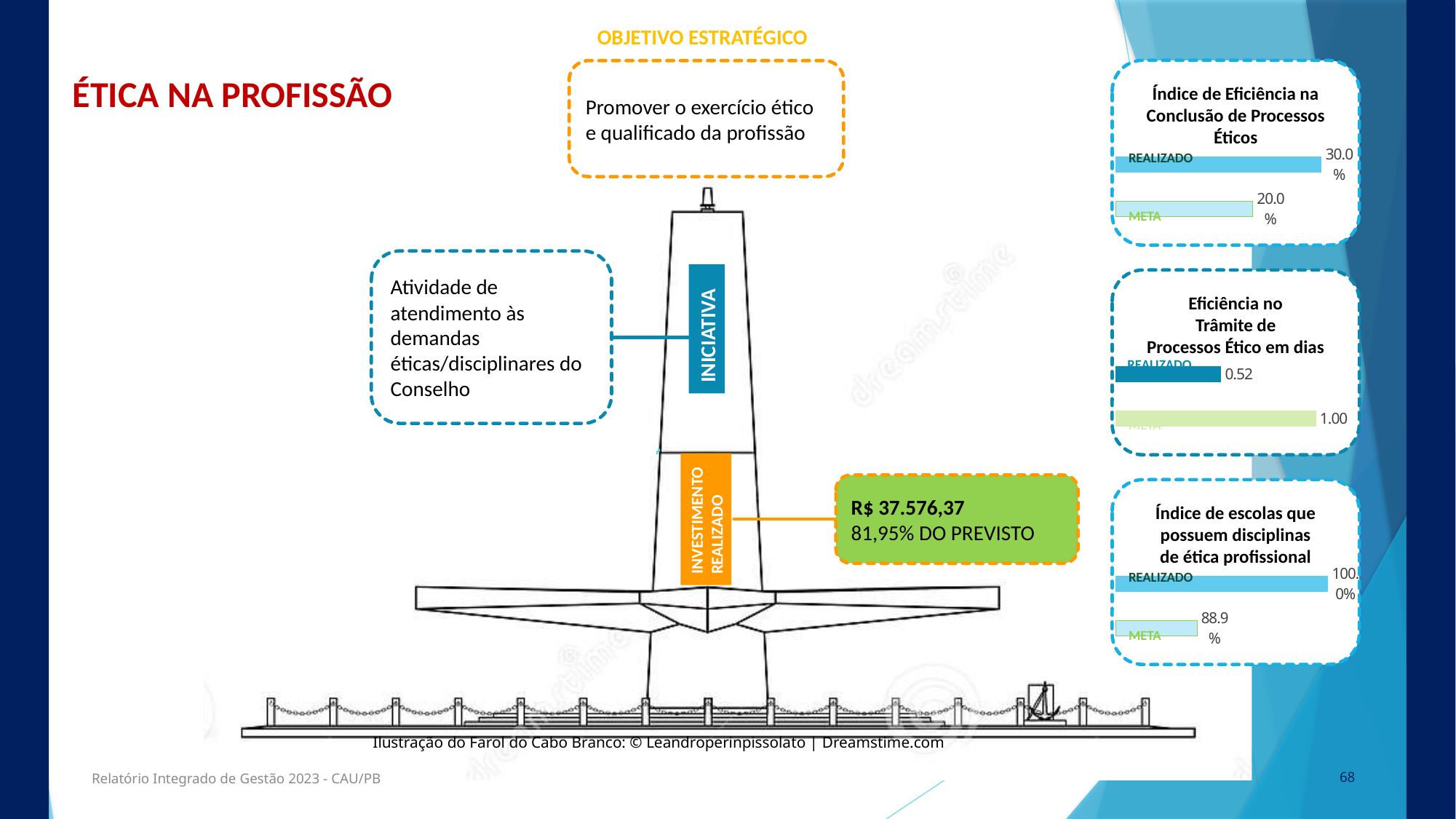
In the chart 'Índice de escolas que possuem disciplinas de ética profissional', which bar is the lowest? META In the chart 'Índice de escolas que possuem disciplinas de ética profissional', what is the value for META? 88.9% In the chart 'Índice de Eficiência na Conclusão de Processos Éticos', what is the value for REALIZADO? 30.0% In the chart 'Índice de Eficiência na Conclusão de Processos Éticos', what is the value for META? 20.0% In the chart 'Eficiência no Trâmite de Processos Ético em dias', what is the value for META? 1.00 What type of chart is 'Eficiência no Trâmite de Processos Ético em dias'? Bar chart In the chart 'Eficiência no Trâmite de Processos Ético em dias', which bar is larger, REALIZADO or META? META In the chart 'Índice de escolas que possuem disciplinas de ética profissional', what is the value for REALIZADO? 100.0% In the chart 'Índice de Eficiência na Conclusão de Processos Éticos', which bar is larger, REALIZADO or META? REALIZADO How many bars does the chart 'Índice de escolas que possuem disciplinas de ética profissional' show? 2 In the chart 'Índice de Eficiência na Conclusão de Processos Éticos', what is the difference between REALIZADO and META? 10.0% In the chart 'Eficiência no Trâmite de Processos Ético em dias', what is the value for REALIZADO? 0.52